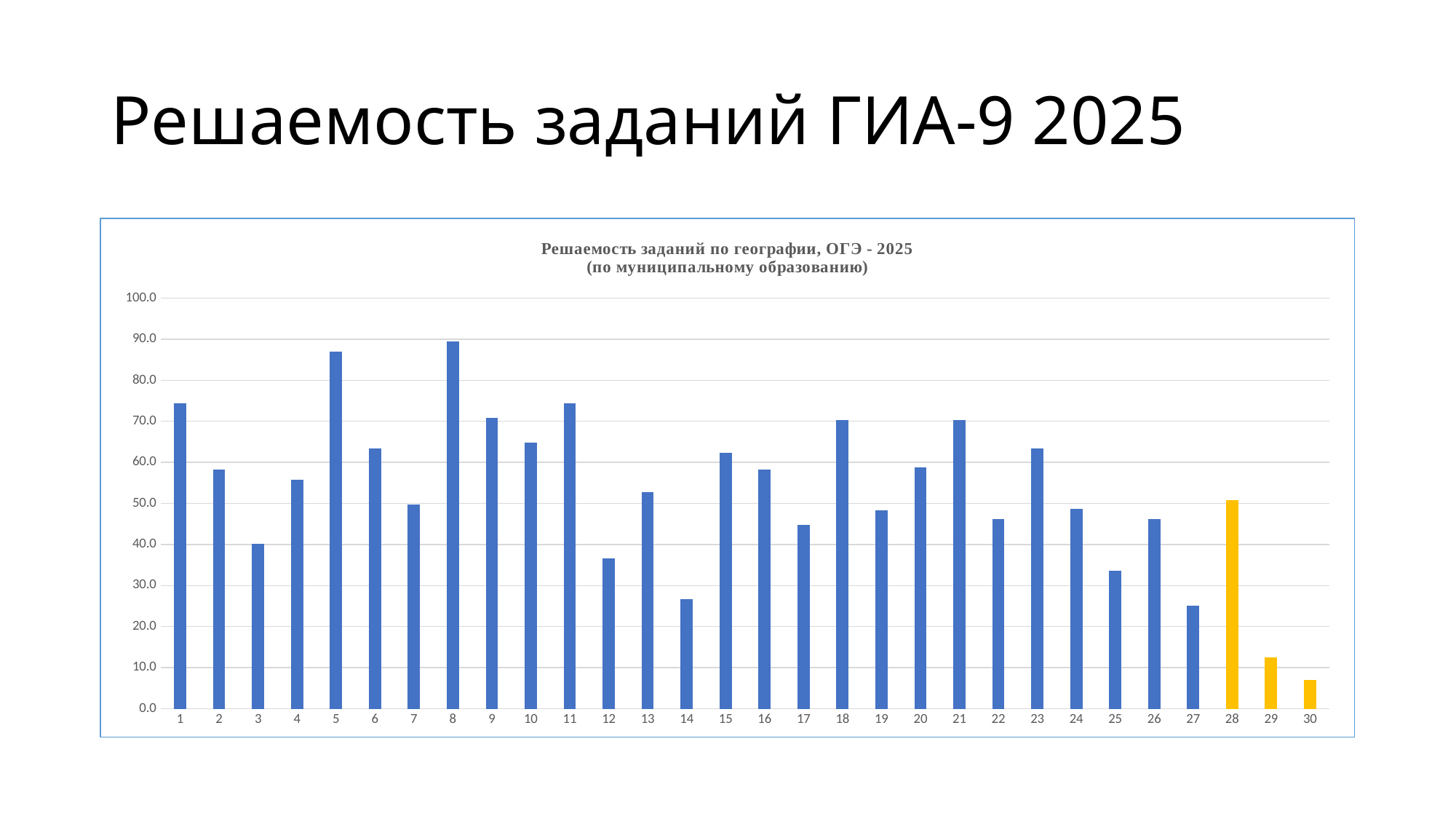
What is the title of the chart? Решаемость заданий по географии, ОГЭ - 2025 (по муниципальному образованию) What kind of chart is shown on the slide? bar chart Which has the larger value, task 9 or task 10? task 9 Is the value for task 14 greater or less than 30.0? less Which task has the highest value in the chart? 8 Which has the larger value, task 29 or task 30? task 29 Which task has the lowest value in the chart? 30 Is the value for task 17 greater or less than 50.0? less Is the value for task 1 greater or less than 70.0? greater Which tasks are shown with yellow bars instead of blue? 28, 29, 30 How many tasks (categories) are shown on the x axis of the chart? 30